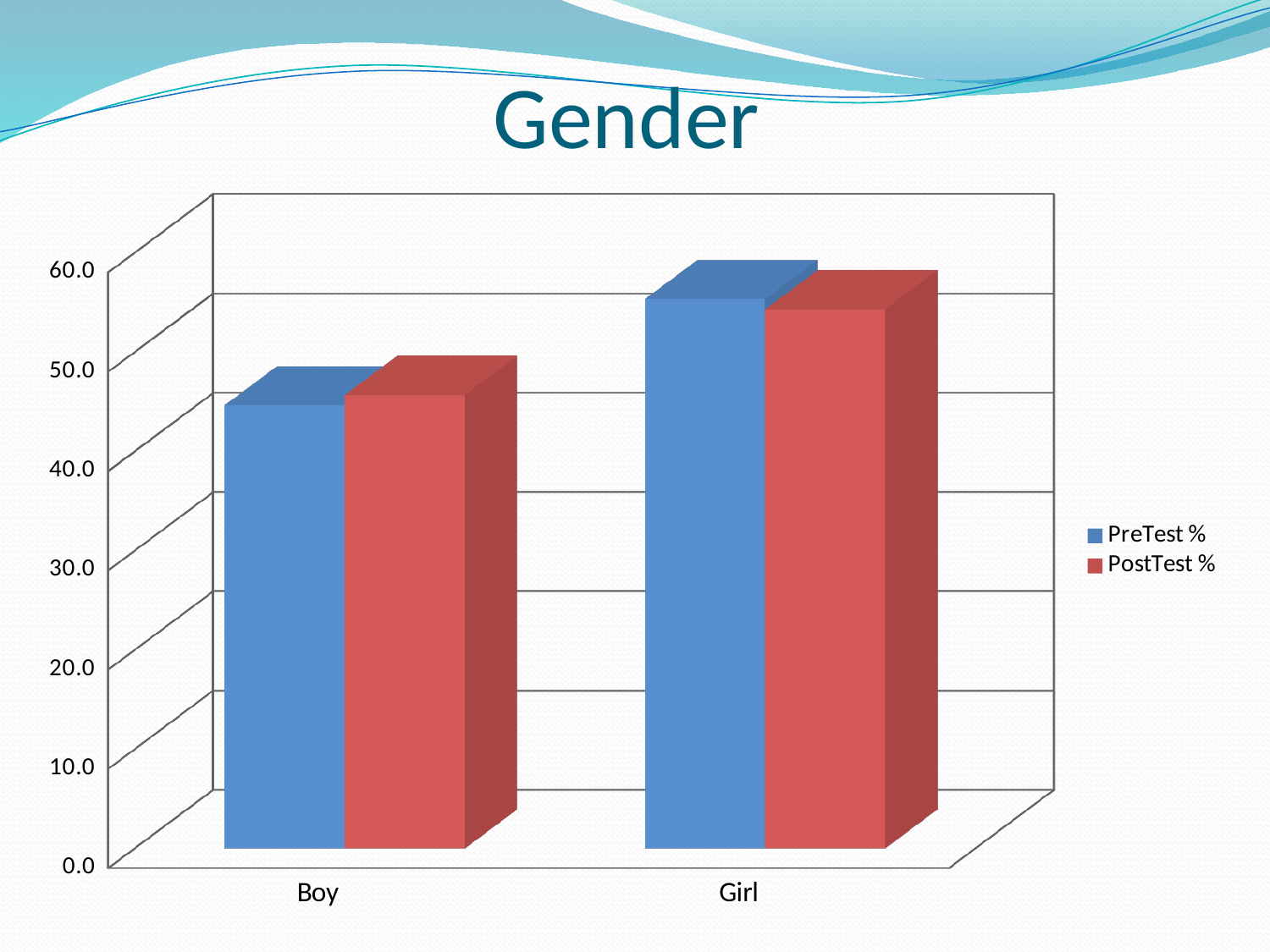
Is the PostTest % value for Girl greater or less than 60.0? less What is the title of the chart? Gender Is the PostTest % value for Boy greater or less than 40.0? greater Which category has the highest PostTest % value? Girl What kind of chart is shown on the slide? bar chart Which category has the lowest PreTest % value? Boy How many categories are shown on the x axis of the chart? 2 How many series does the chart's legend list? 2 Which category has the higher PreTest % value, Boy or Girl? Girl Which series is shown in red in the chart? PostTest % Is the PreTest % value for Girl greater or less than 50.0? greater